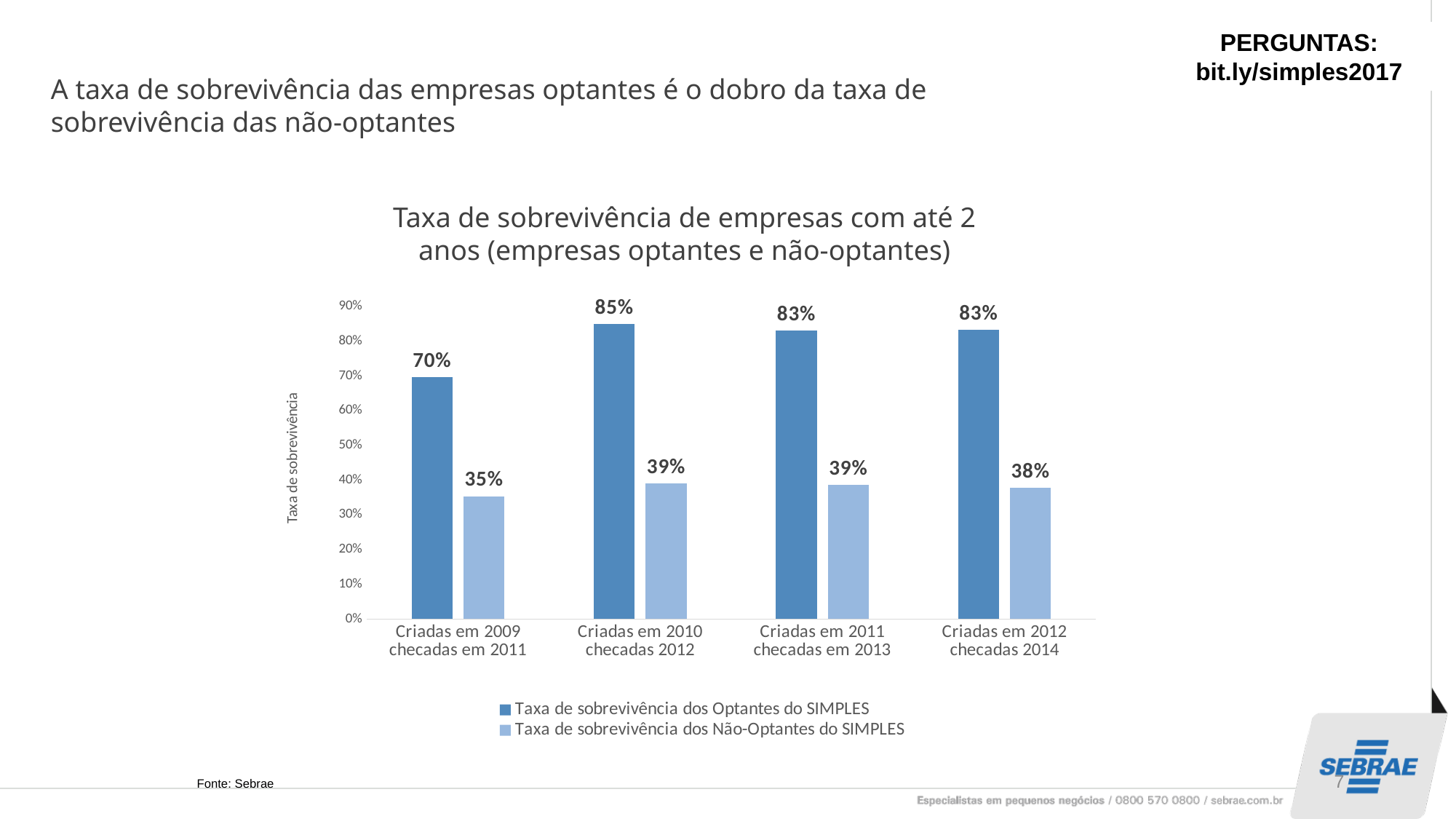
Which is larger: the Optantes survival rate for 'Criadas em 2009 checadas em 2011' or for 'Criadas em 2012 checadas em 2014'? Criadas em 2012 checadas em 2014 Which category has the highest survival rate for Optantes do SIMPLES? Criadas em 2010 checadas em 2012 What is the survival rate of Optantes do SIMPLES for companies 'Criadas em 2010 checadas em 2012'? 85% Is the Optantes do SIMPLES survival rate for 'Criadas em 2009 checadas em 2011' greater or less than 60%? greater What is the survival rate of Não-Optantes do SIMPLES for companies 'Criadas em 2012 checadas em 2014'? 38% How many categories are shown on the x axis? 4 Which category has the lowest survival rate for Não-Optantes do SIMPLES? Criadas em 2009 checadas em 2011 What is the difference between the Optantes and Não-Optantes survival rates for companies 'Criadas em 2011 checadas em 2013'? 44% What is the title of the chart? Taxa de sobrevivência de empresas com até 2 anos (empresas optantes e não-optantes) What is the survival rate of Não-Optantes do SIMPLES for companies 'Criadas em 2009 checadas em 2011'? 35% What kind of chart is shown on the slide? Bar chart How many series does the legend list? 2